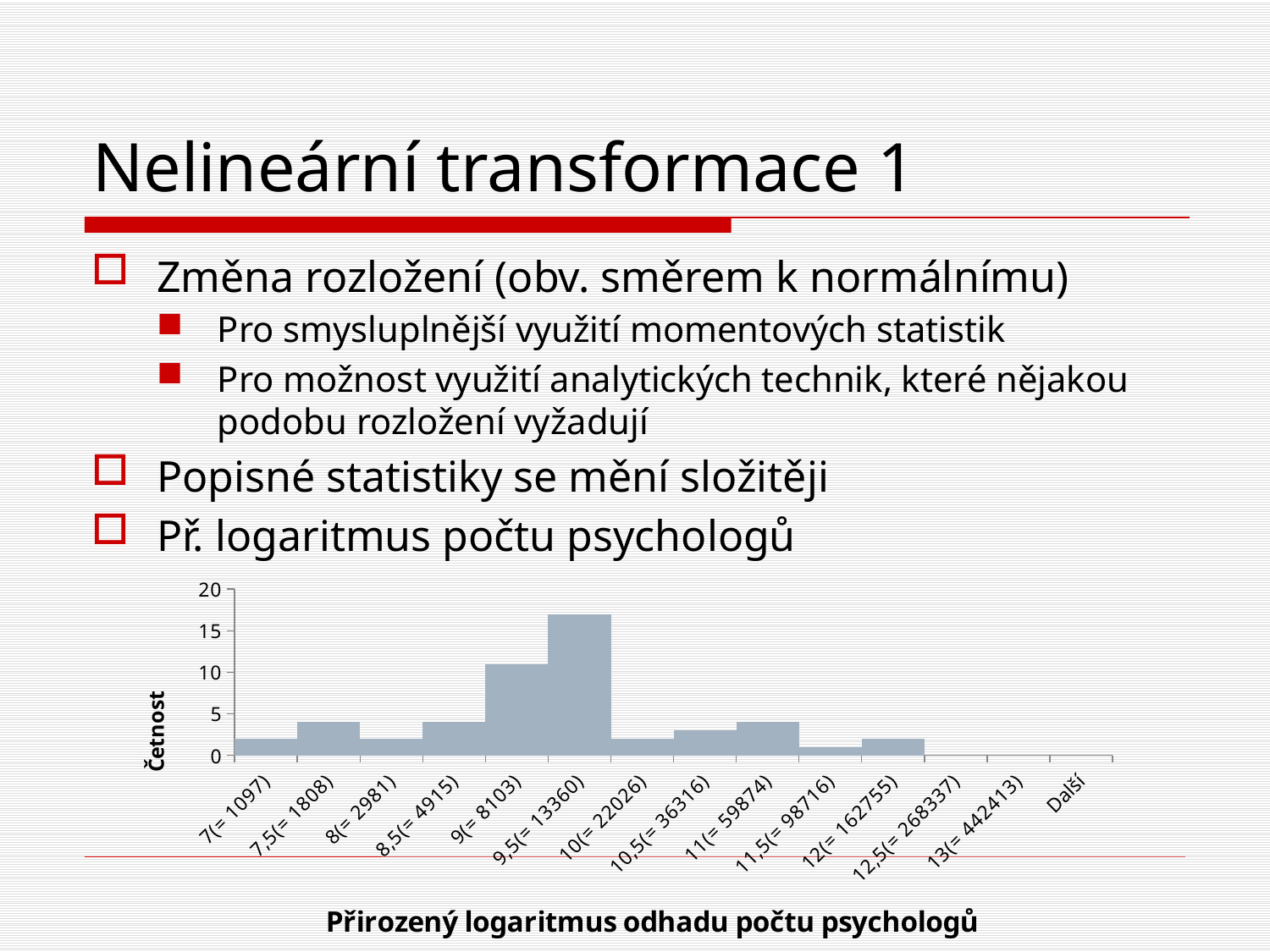
What kind of chart is shown on the slide? bar chart Which is larger, the value for 9,5(= 13360) or the value for 9(= 8103)? 9,5(= 13360) Which category has the highest frequency (Četnost) in the chart? 9,5(= 13360) How many categories are shown on the x axis of the chart? 14 What is the label of the horizontal axis of the chart? Přirozený logaritmus odhadu počtu psychologů Is the value for 7(= 1097) greater or less than 5? less Is the value for 9,5(= 13360) greater or less than 15? greater What is the label of the vertical axis of the chart? Četnost Is the value for 10(= 22026) greater or less than 5? less Which is larger, the value for 9(= 8103) or the value for 10(= 22026)? 9(= 8103)